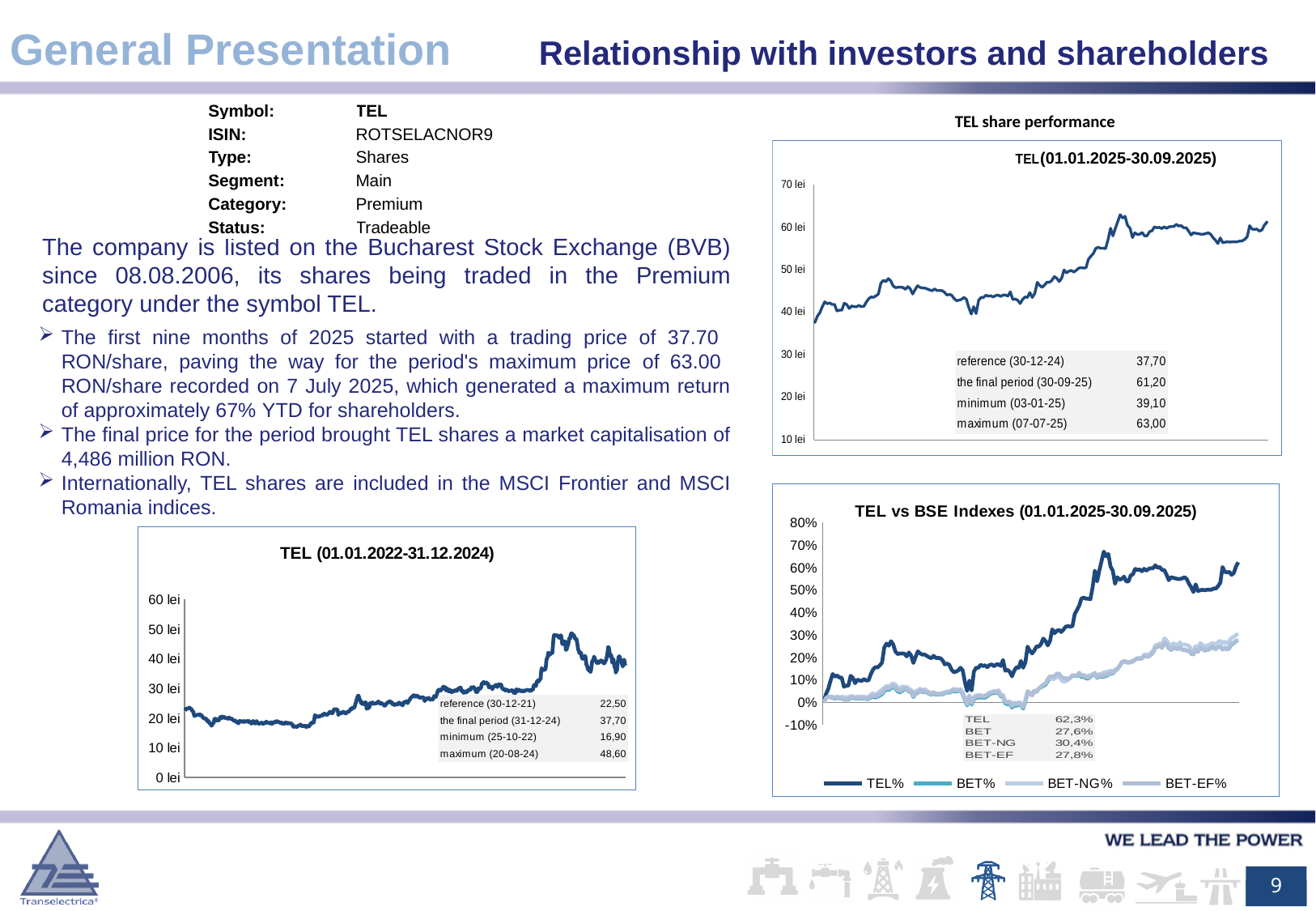
In the 'TEL (01.01.2025-30.09.2025)' chart, what is the maximum value (07-07-25)? 63,00 How many series does the legend of the 'TEL vs BSE Indexes (01.01.2025-30.09.2025)' chart list? 4 In the 'TEL vs BSE Indexes (01.01.2025-30.09.2025)' chart, which series has the lowest value in the table? BET In the 'TEL vs BSE Indexes (01.01.2025-30.09.2025)' chart, which series has the highest value in the table? TEL In the 'TEL (01.01.2025-30.09.2025)' chart, what is the difference between the final period value (30-09-25) and the reference value (30-12-24)? 23,50 In the 'TEL (01.01.2022-31.12.2024)' chart, what is the final period value (31-12-24)? 37,70 What kind of chart is the 'TEL (01.01.2022-31.12.2024)' chart? Line chart In the 'TEL (01.01.2025-30.09.2025)' chart, what is the reference value (30-12-24)? 37,70 In the 'TEL vs BSE Indexes (01.01.2025-30.09.2025)' chart, what is the value shown for TEL? 62,3% In the 'TEL (01.01.2025-30.09.2025)' chart, what is the minimum value (03-01-25)? 39,10 In the 'TEL (01.01.2022-31.12.2024)' chart, what is the minimum value (25-10-22)? 16,90 In the 'TEL (01.01.2022-31.12.2024)' chart, what is the difference between the maximum (20-08-24) and the reference (30-12-21)? 26,10